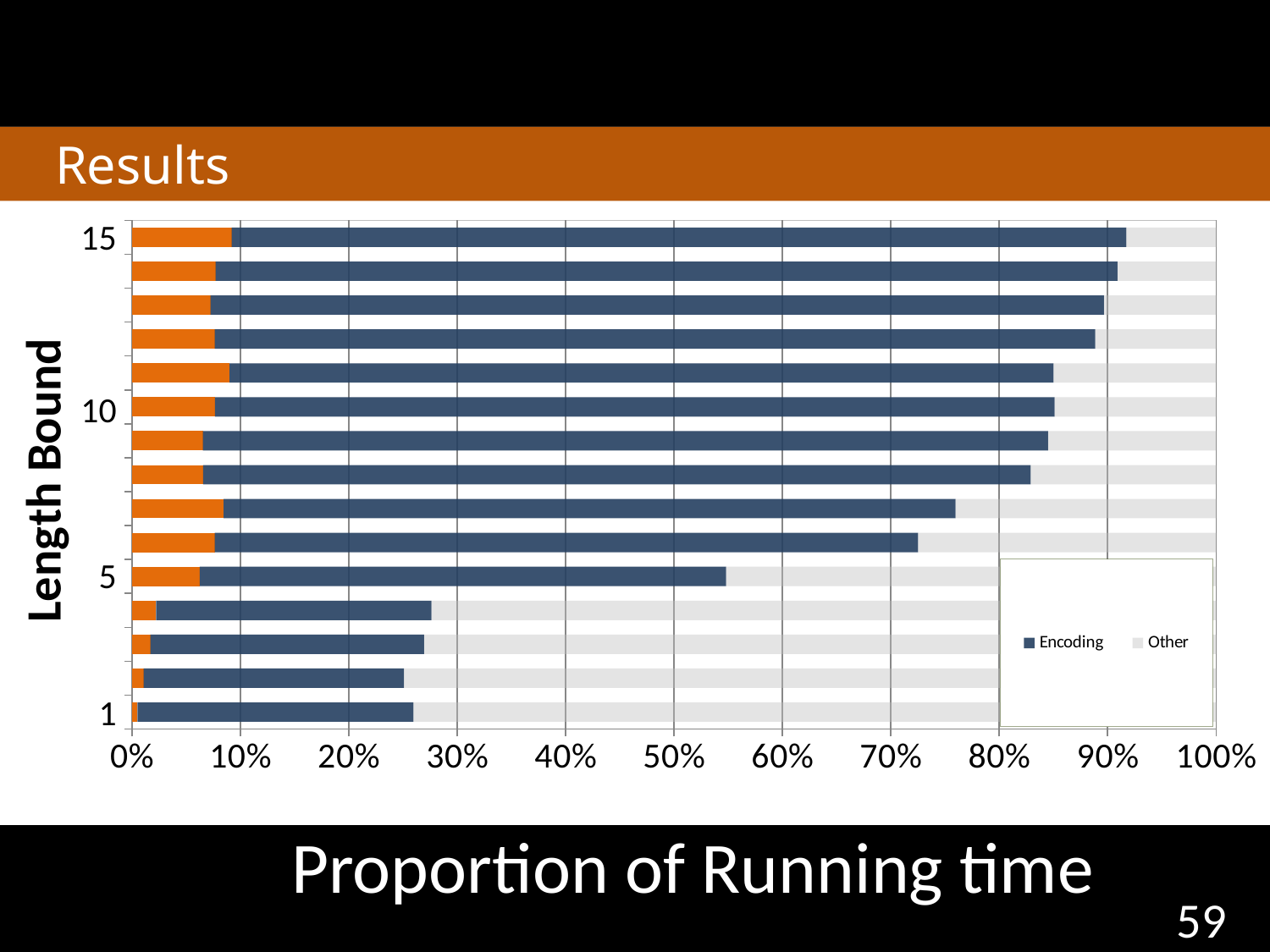
Is the point where the Encoding segment ends for length bound 1 greater or less than 30%? less Is the point where the Encoding segment ends for length bound 10 greater or less than 80%? greater What label appears below the horizontal axis of the chart? Proportion of Running time Which has the larger Encoding share: length bound 15 or length bound 1? Length bound 15 Is the Other share for length bound 1 greater or less than 70%? greater As the length bound increases from 1 to 15, does the Encoding share generally rise or fall? Rise How many series does the visible legend list? 2 What kind of chart is shown on the slide? Stacked bar chart How many bars (length bounds) are plotted in the chart? 15 What is the title of the vertical axis? Length Bound